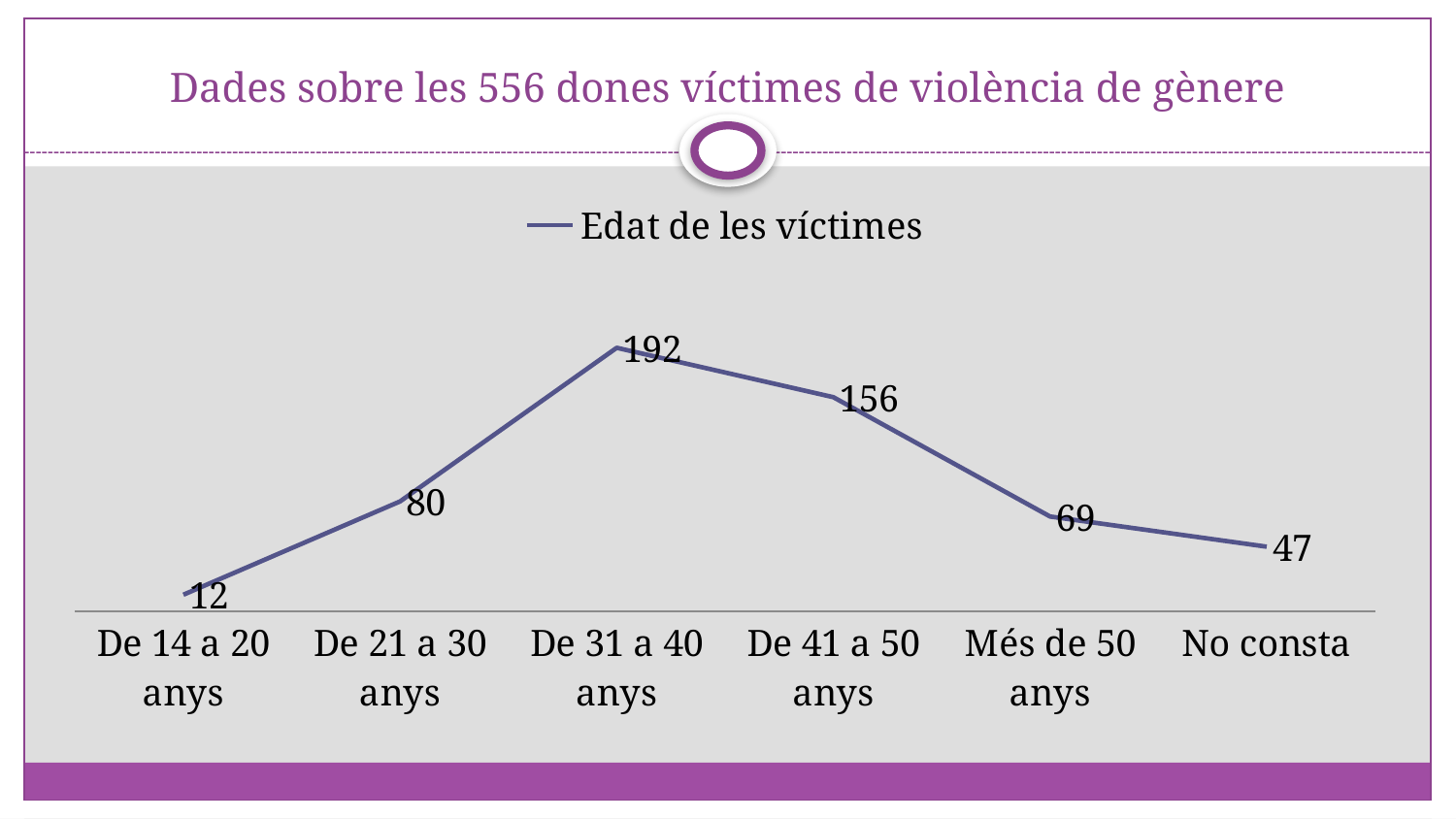
What is the value for 'De 21 a 30 anys'? 80 What is the value for 'No consta'? 47 What is the difference between the values for 'De 31 a 40 anys' and 'De 41 a 50 anys'? 36 Which category has the highest value? De 31 a 40 anys What kind of chart is shown on the slide? line chart Which is larger, the value for 'Més de 50 anys' or the value for 'No consta'? Més de 50 anys How many series does the legend list? 1 Which category has the lowest value? De 14 a 20 anys How many categories are shown on the x axis? 6 Do the values rise or fall from 'De 31 a 40 anys' to 'No consta'? fall What is the name of the series shown in the legend? Edat de les víctimes What is the value for 'De 31 a 40 anys'? 192